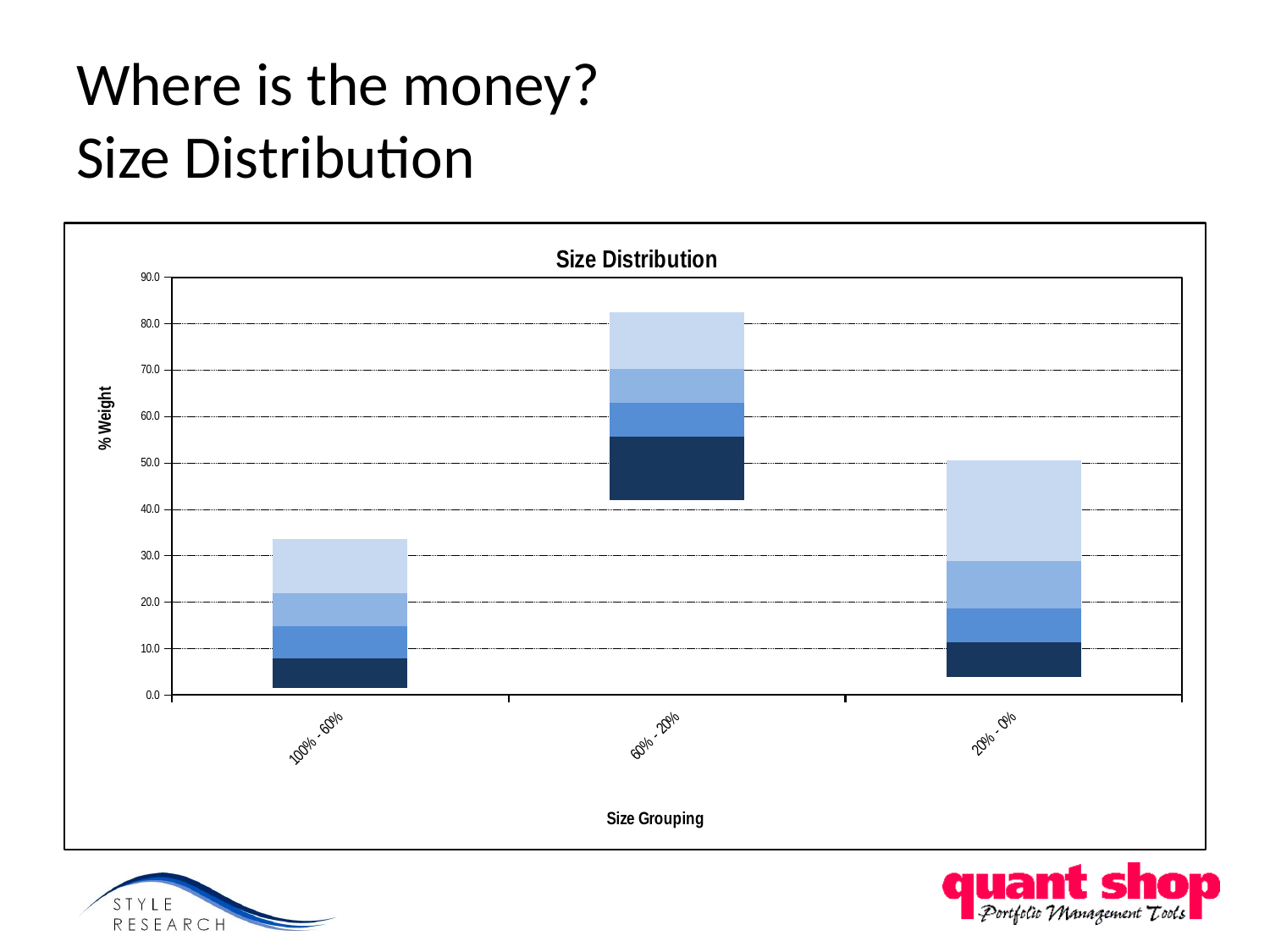
Which bar reaches higher on the % Weight axis: 60% - 20% or 20% - 0%? 60% - 20% What is the title of the chart? Size Distribution What is the highest value shown on the vertical axis? 90.0 What is the label on the vertical axis of the chart? % Weight Is the top of the bar for the 100% - 60% grouping greater or less than 40.0? less Is the top of the bar for the 60% - 20% grouping greater or less than 80.0? greater Which size grouping has the bar with the lowest top? 100% - 60% Is the bottom of the bar for the 60% - 20% grouping greater or less than 30.0? greater What kind of chart is shown on the slide? Stacked bar chart How many size groupings are shown on the x axis of the chart? 3 Which size grouping has the bar that reaches the highest % Weight? 60% - 20%